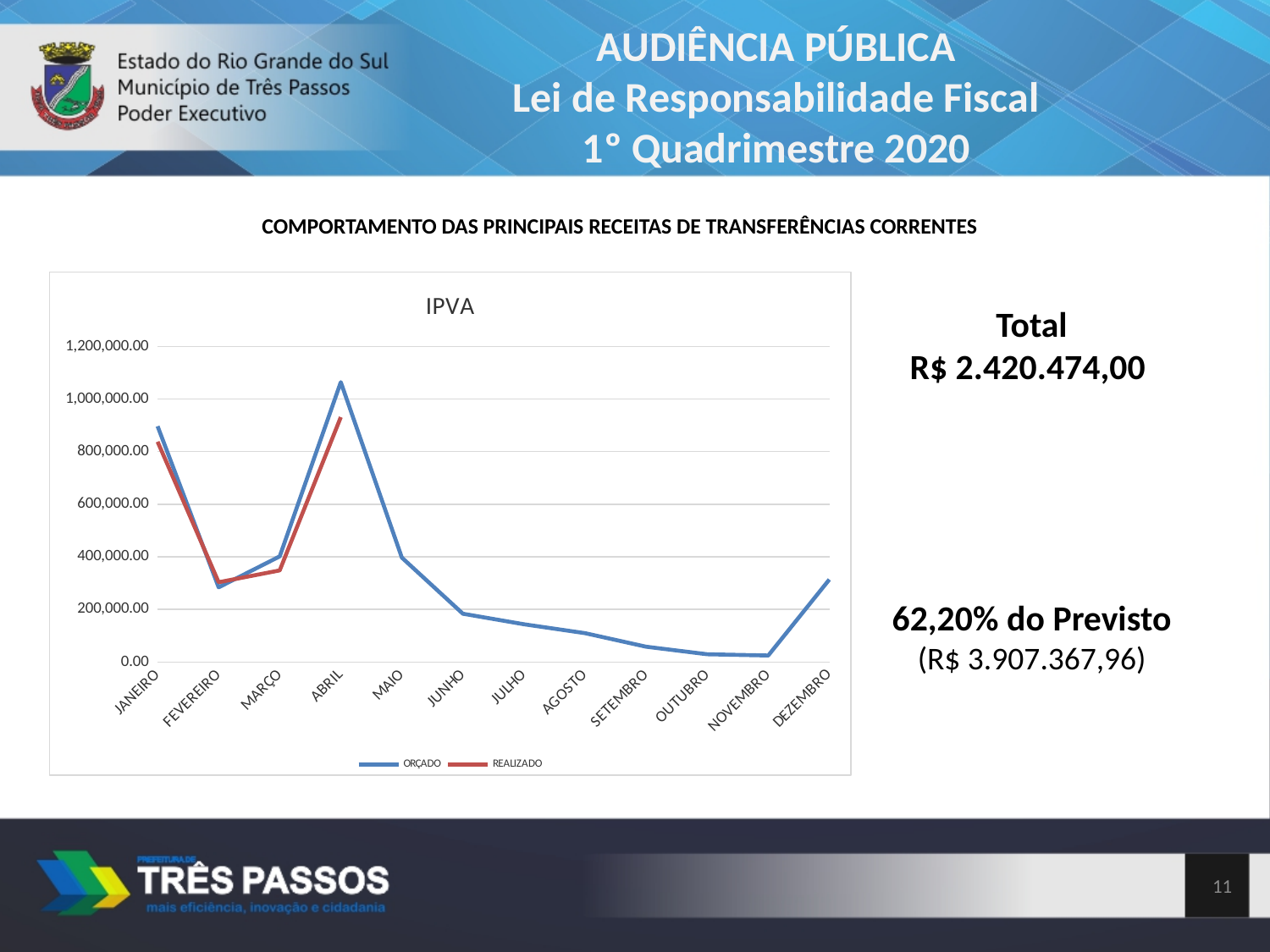
Is the REALIZADO value for ABRIL greater or less than 800,000.00? greater In which month does the ORÇADO series reach its highest value in the IPVA chart? ABRIL Does the ORÇADO series rise or fall from ABRIL to NOVEMBRO? fall In ABRIL, which series has the larger value, ORÇADO or REALIZADO? ORÇADO For how many months does the REALIZADO series have plotted values? 4 Is the REALIZADO value for FEVEREIRO greater or less than 400,000.00? less How many months are shown on the x axis of the IPVA chart? 12 What colour is the REALIZADO line in the IPVA chart? red What kind of chart is the IPVA chart? line chart How many series does the legend of the IPVA chart list? 2 Is the ORÇADO value for ABRIL greater or less than 1,000,000.00? greater